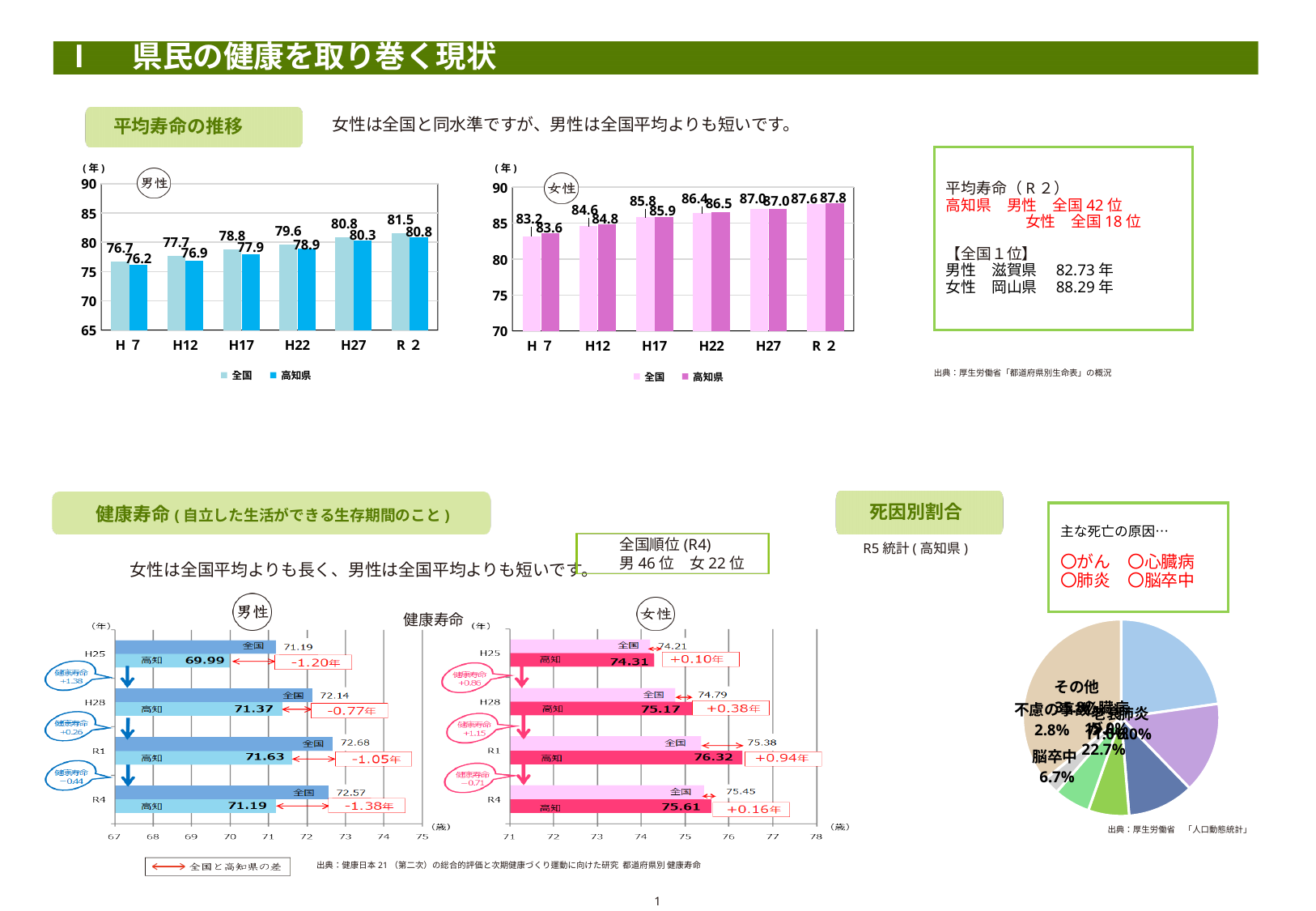
In the male life expectancy chart (平均寿命の推移, 男性), what is the value for 全国 in H7? 76.7 In the female healthy life expectancy chart (健康寿命, 女性), what is the value for 全国 in R4? 75.45 In the male life expectancy chart (平均寿命の推移, 男性), what is the difference between 全国 and 高知県 in R2? 0.7 In the female healthy life expectancy chart (健康寿命, 女性), which is larger in R1, 全国 or 高知? 高知 In the pie chart of causes of death (死因別割合), what share is shown for 脳卒中? 6.7% How many series does the legend of the male life expectancy chart (平均寿命の推移, 男性) list? 2 How many year categories are shown on the x axis of the female life expectancy chart (平均寿命の推移, 女性)? 6 In the female life expectancy chart (平均寿命の推移, 女性), do the 高知県 values rise or fall from H7 to R2? rise In the male life expectancy chart (平均寿命の推移, 男性), what is the value for 高知県 in R2? 80.8 In the female life expectancy chart (平均寿命の推移, 女性), which year has the highest value for 全国? R2 In the female life expectancy chart (平均寿命の推移, 女性), what is the value for 高知県 in H17? 85.9 In the male healthy life expectancy chart (健康寿命, 男性), what is the value for 高知 in R1? 71.63